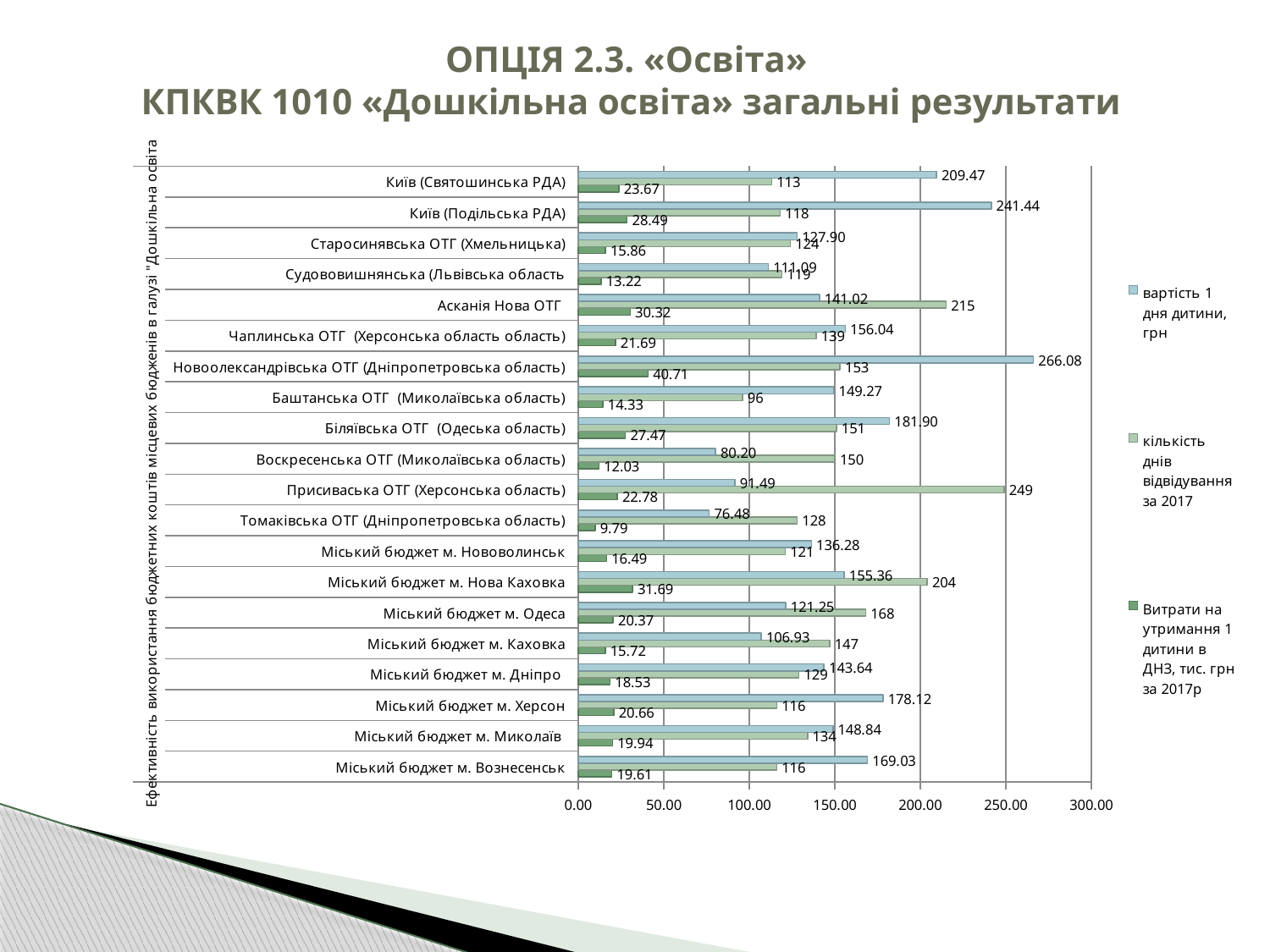
How many series does the legend list? 3 What is the value of "вартість 1 дня дитини, грн" for Київ (Подільська РДА)? 241.44 Which category has the highest value of "вартість 1 дня дитини, грн"? Новоолександрівська ОТГ (Дніпропетровська область) What is the difference in "вартість 1 дня дитини, грн" between Київ (Подільська РДА) and Київ (Святошинська РДА)? 31.97 Which category has the highest value of "кількість днів відвідування за 2017"? Присиваська ОТГ (Херсонська область) Which category has the lowest value of "кількість днів відвідування за 2017"? Баштанська ОТГ (Миколаївська область) Which is larger: the "Витрати на утримання 1 дитини в ДНЗ" value for Міський бюджет м. Херсон or for Міський бюджет м. Одеса? Міський бюджет м. Херсон What is the value of "кількість днів відвідування за 2017" for Асканія Нова ОТГ? 215 What is the value of "Витрати на утримання 1 дитини в ДНЗ, тис. грн за 2017р" for Міський бюджет м. Нова Каховка? 31.69 How many categories (budgets) are plotted on the chart? 20 What type of chart is shown on the slide? bar chart Which category has the lowest value of "вартість 1 дня дитини, грн"? Томаківська ОТГ (Дніпропетровська область)